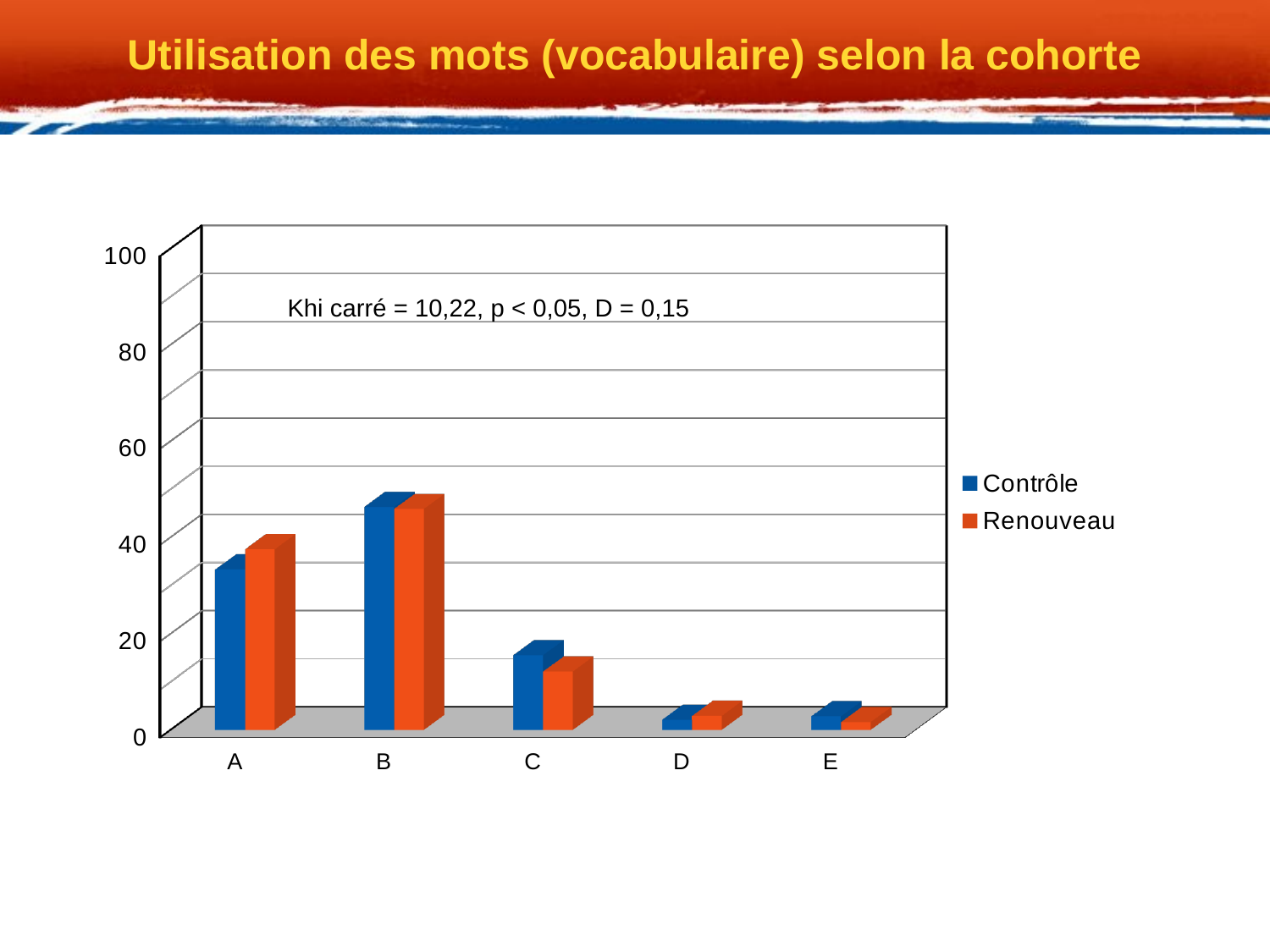
Which category has the highest value for the Renouveau series? B Is the value for Renouveau in category B greater or less than 60? less What kind of chart is shown on the slide? bar chart Is the value for Contrôle in category B greater or less than 40? greater In category A, which series has the larger value, Contrôle or Renouveau? Renouveau What are the two series named in the legend? Contrôle and Renouveau Is the value for Renouveau in category C greater or less than 20? less Which category has the highest value for the Contrôle series? B In category C, which series has the larger value, Contrôle or Renouveau? Contrôle How many categories are shown on the x axis? 5 How many series does the legend list? 2